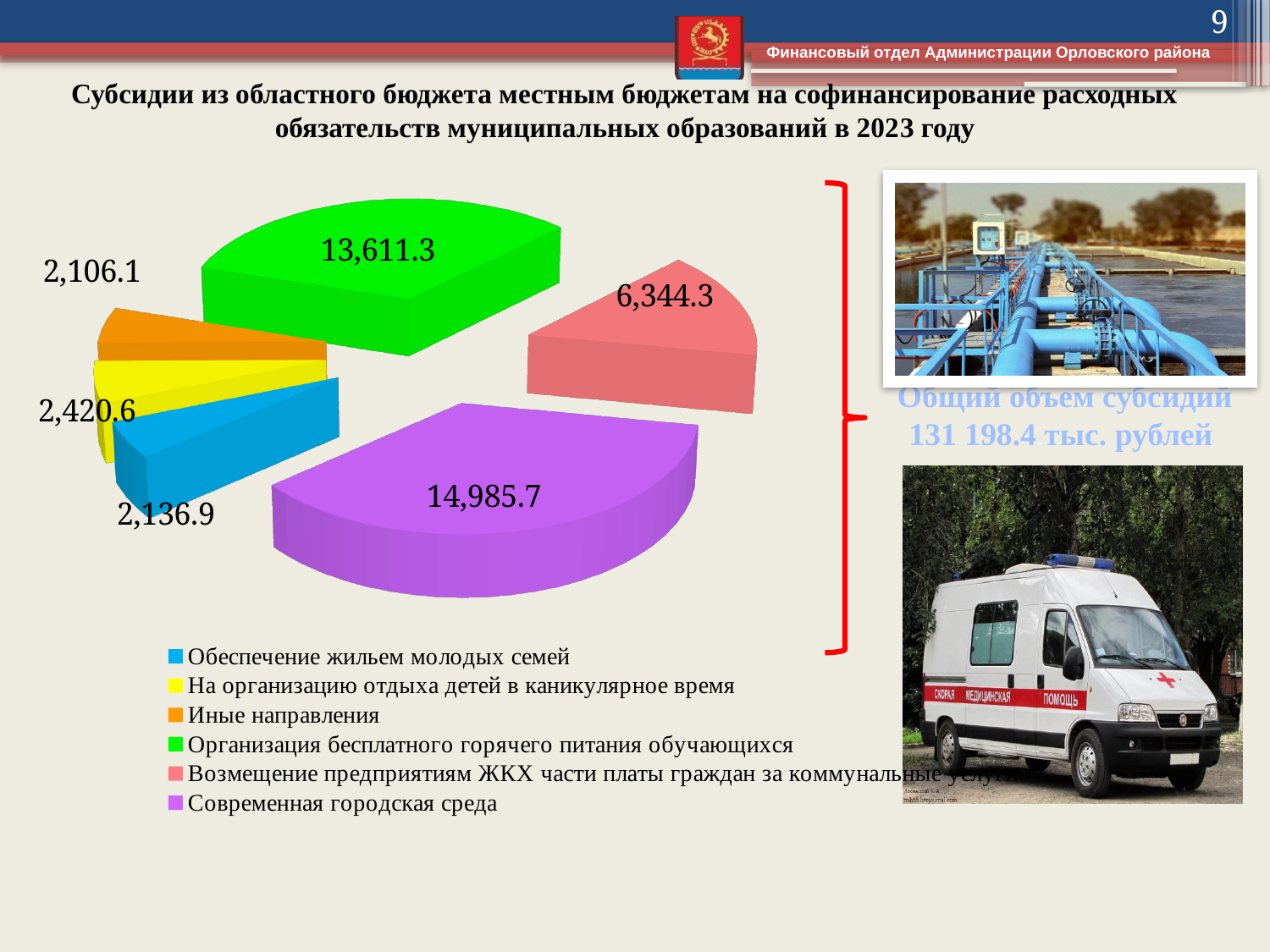
Which category has the smallest slice of the pie? Иные направления What value is shown for the slice "Обеспечение жильем молодых семей"? 2,136.9 What value is shown for the slice "Современная городская среда"? 14,985.7 What kind of chart is shown on the slide? Pie chart Which category has the largest slice of the pie? Современная городская среда What value is shown for the slice "Возмещение предприятиям ЖКХ части платы граждан за коммунальные услуги"? 6,344.3 What value is shown for the slice "На организацию отдыха детей в каникулярное время"? 2,420.6 What is the difference between the values for "Современная городская среда" and "Организация бесплатного горячего питания обучающихся"? 1,374.4 Which is larger: the value for "На организацию отдыха детей в каникулярное время" or for "Обеспечение жильем молодых семей"? На организацию отдыха детей в каникулярное время What value is shown for the slice "Организация бесплатного горячего питания обучающихся"? 13,611.3 What value is shown for the slice "Иные направления"? 2,106.1 How many slices does the pie chart have? 6